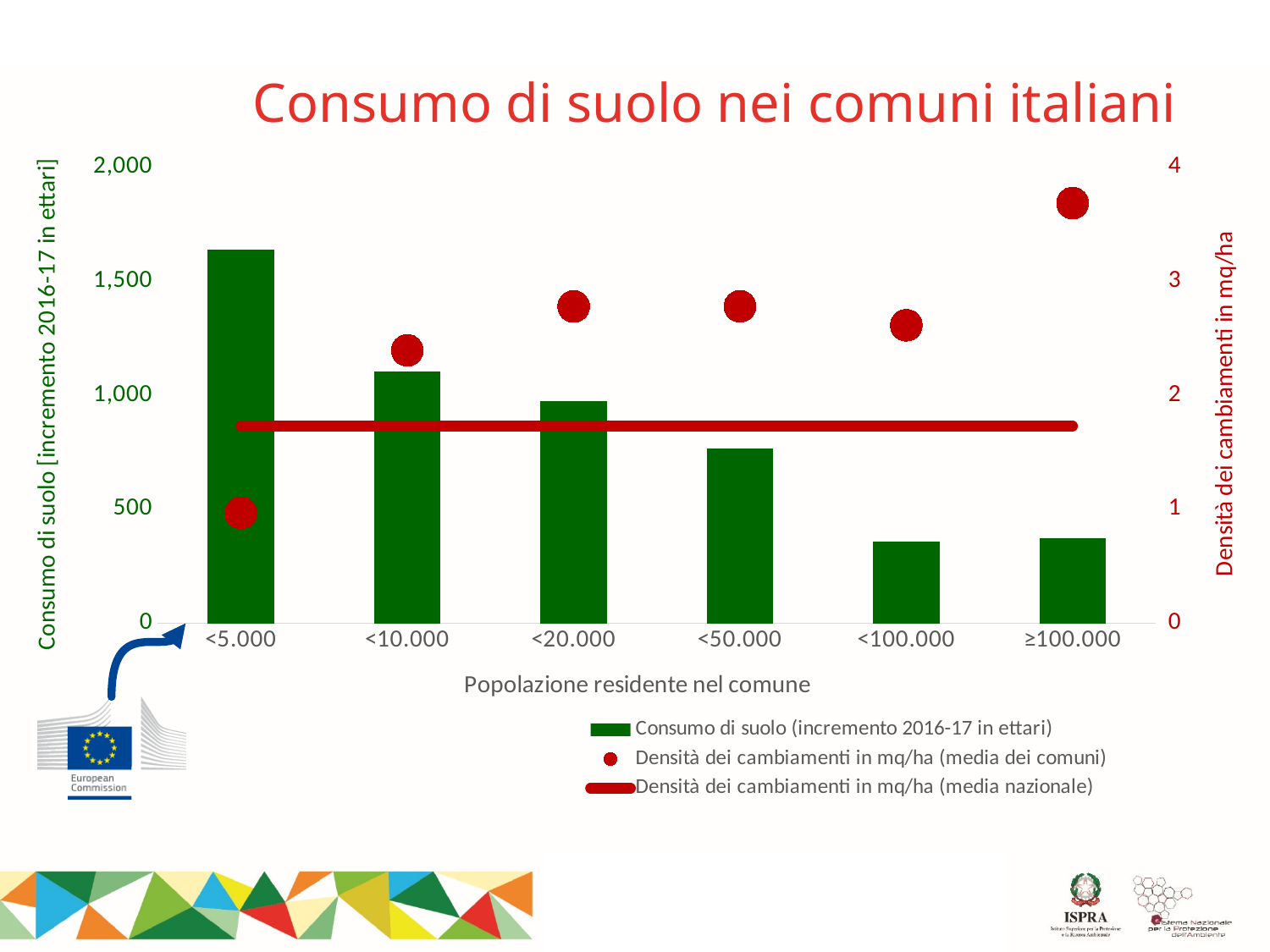
How many population categories are shown on the x axis? 6 What is the title of the chart? Consumo di suolo nei comuni italiani How many series does the legend list? 3 Is the Consumo di suolo bar for <100.000 greater or less than 500? less Which population category has the highest bar for Consumo di suolo (incremento 2016-17 in ettari)? <5.000 Is the Consumo di suolo bar for <5.000 greater or less than 1,500? greater What kind of chart is shown on the slide? A combined bar and scatter/line chart (bars with dots and a line) Is the Densità dei cambiamenti (media dei comuni) dot for ≥100.000 greater or less than 3? greater Which has the larger Consumo di suolo bar, <5.000 or <10.000? <5.000 Which population category has the lowest dot for Densità dei cambiamenti in mq/ha (media dei comuni)? <5.000 Which population category has the highest dot for Densità dei cambiamenti in mq/ha (media dei comuni)? ≥100.000